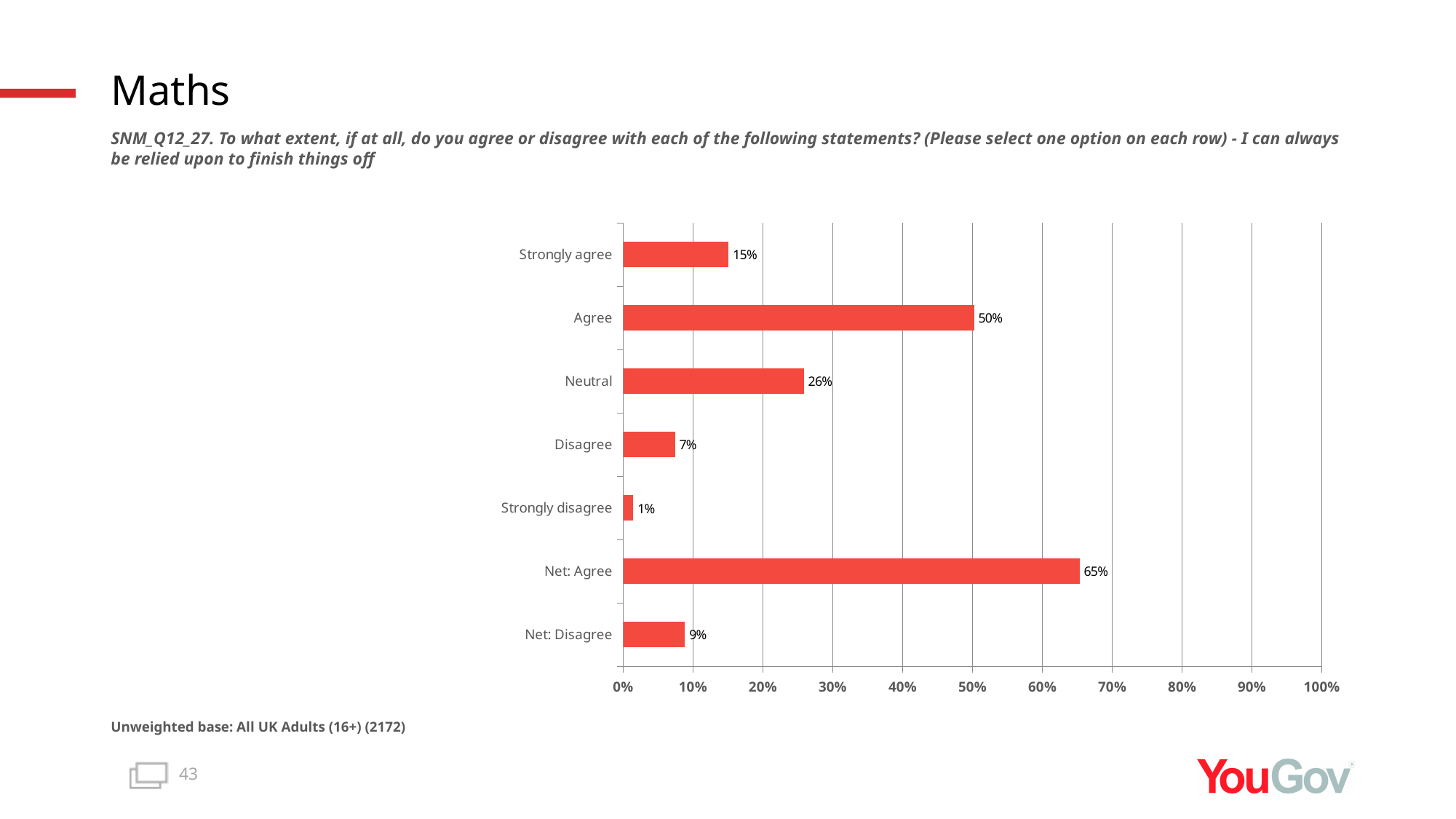
Which category has the lowest value? Strongly disagree What is the difference between 'Agree' and 'Strongly agree'? 35% Which category has the highest value? Net: Agree What kind of chart is shown on the slide? Bar chart Is the value for 'Net: Agree' greater or less than 60%? greater What is the value shown for 'Neutral'? 26% What is the maximum value shown on the x axis? 100% What percentage of respondents selected 'Agree'? 50% What is the difference between 'Net: Agree' and 'Net: Disagree'? 56% How many categories are shown on the chart? 7 Which is larger, 'Neutral' or 'Strongly agree'? Neutral What is the value for 'Net: Disagree'? 9%